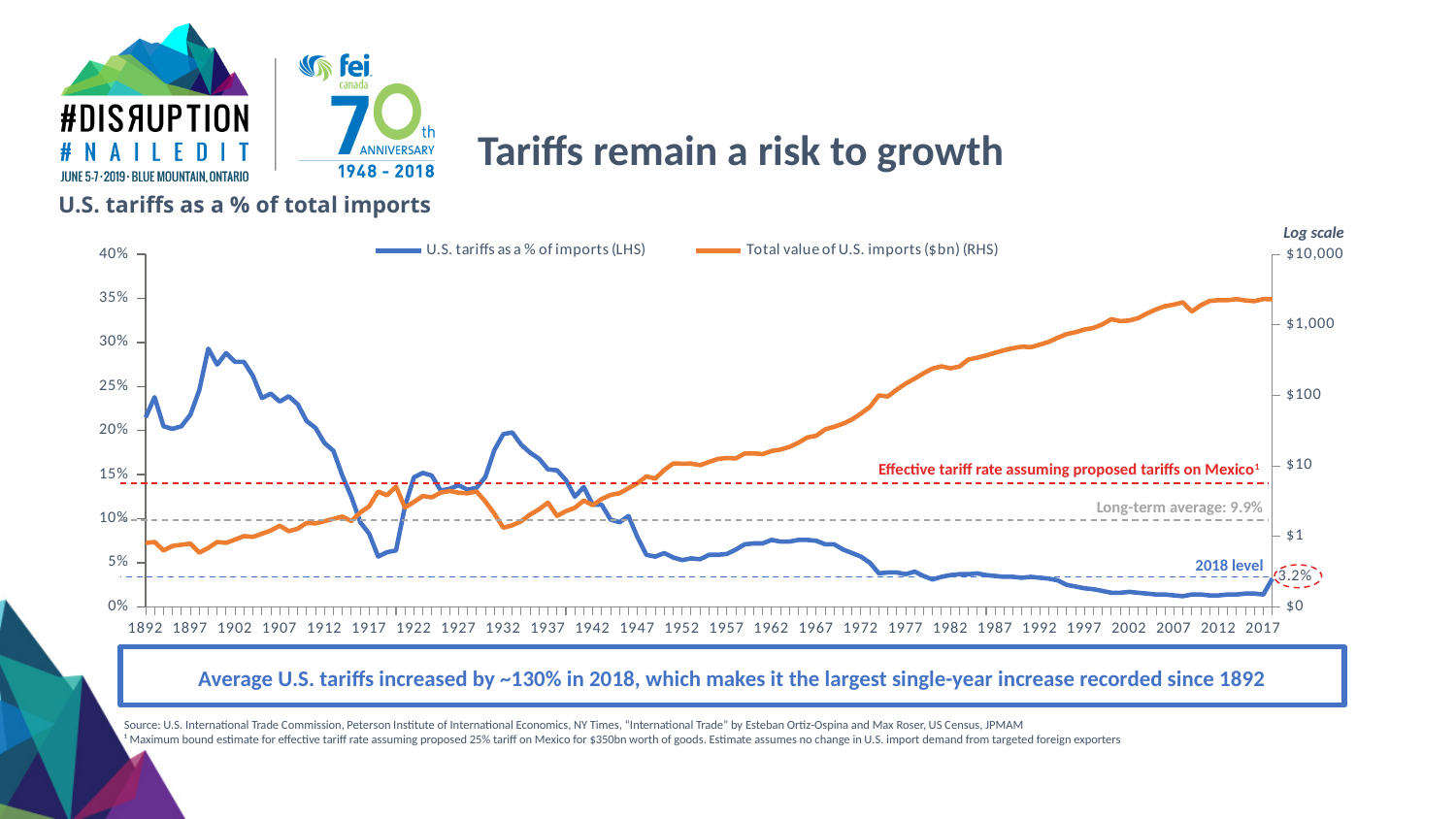
What is the long-term average of U.S. tariffs as a % of imports shown on the chart? 9.9% Which is larger, the long-term average tariff rate or the 2018 level? Long-term average What kind of chart is shown on the slide? Line chart Is the value of U.S. tariffs as a % of imports around 1900 greater or less than 25%? greater Is the total value of U.S. imports in 2017 greater or less than $1,000 billion? greater Does the total value of U.S. imports series generally rise or fall from 1892 to 2017? Rise What type of scale is used on the right-hand axis of the chart? Log scale What is the title of the chart? U.S. tariffs as a % of total imports How many series does the chart legend list? 2 What is the 2018 level of U.S. tariffs as a % of imports shown on the chart? 3.2% What is the difference between the long-term average tariff rate and the 2018 level? 6.7 percentage points Is the value of U.S. tariffs as a % of imports around 1917 greater or less than 10%? less